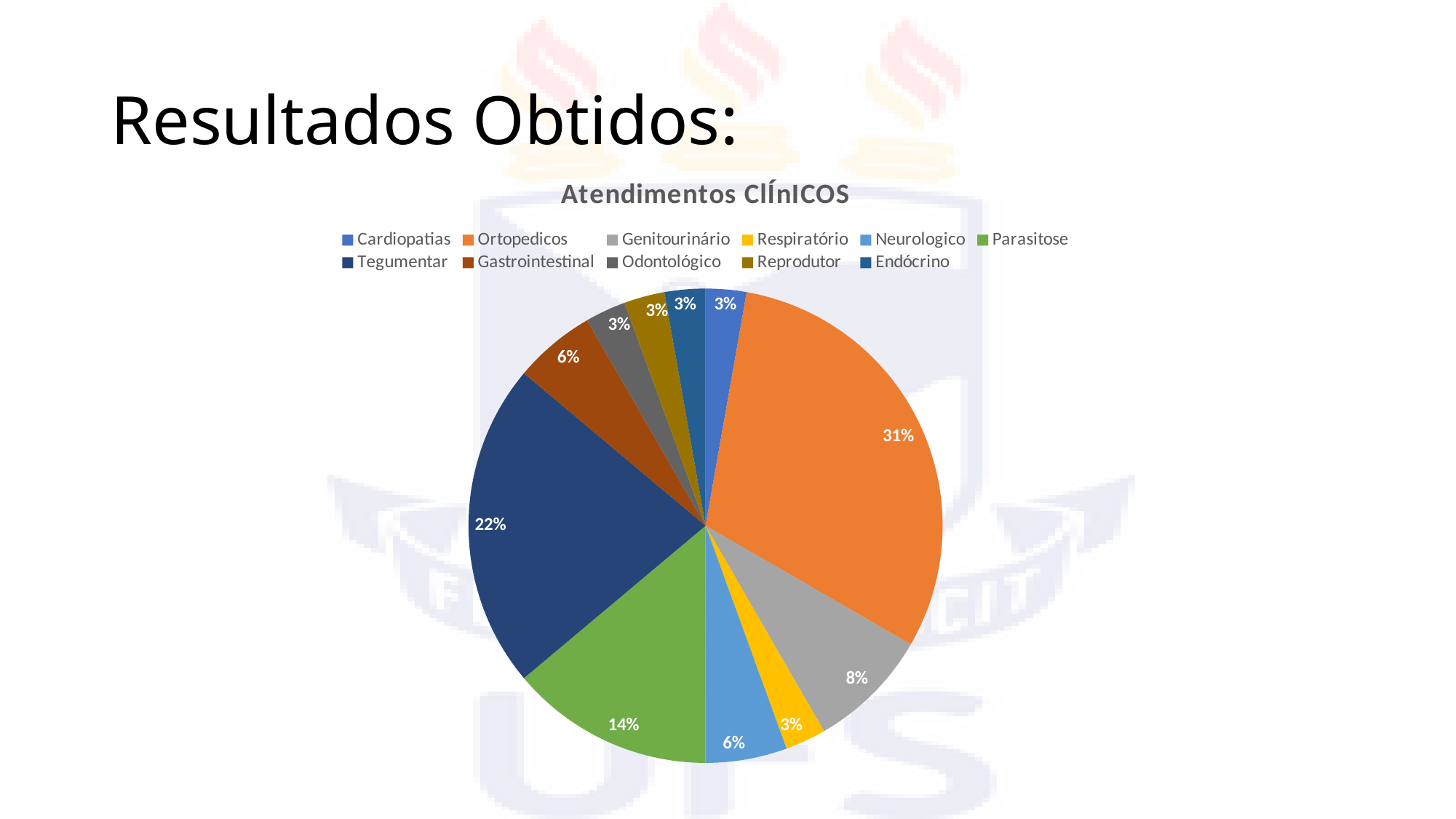
How many categories does the pie chart have? 11 What is the value for Neurologico? 6% What kind of chart is shown on the slide? pie chart Which category has the largest share of the pie? Ortopedicos What is the value for Parasitose? 14% What colour is the Parasitose slice? green What is the title of the chart? Atendimentos ClínICOS What share of the pie does Ortopedicos have? 31% What share of the pie does Tegumentar have? 22% What is the value for Genitourinário? 8% Which is larger, the share for Parasitose or the share for Genitourinário? Parasitose What is the difference between the shares of Ortopedicos and Tegumentar? 9%